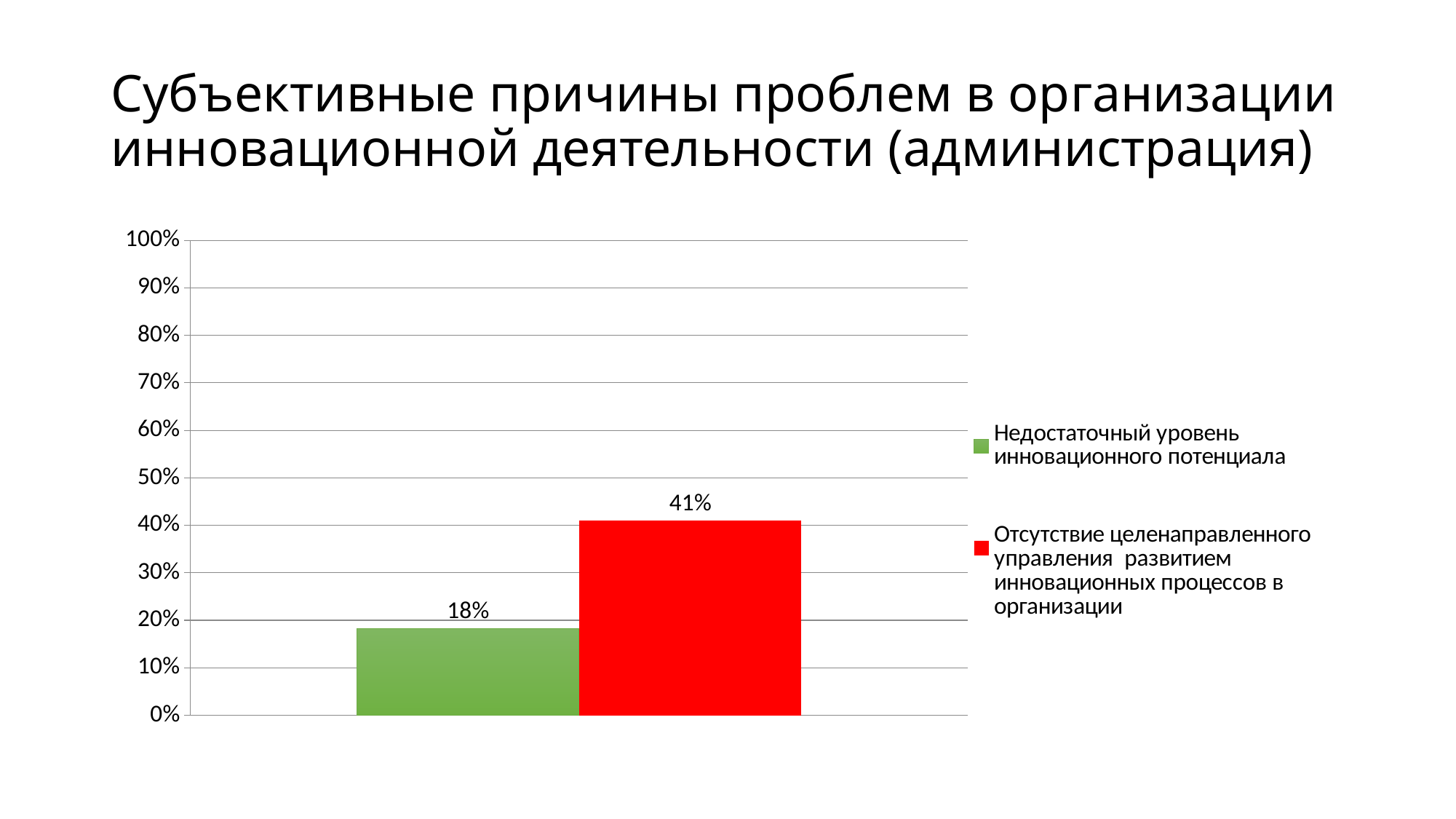
What kind of chart is shown on the slide? bar chart Is the value for 'Отсутствие целенаправленного управления развитием инновационных процессов в организации' greater or less than 50%? less Which series has the highest value? Отсутствие целенаправленного управления развитием инновационных процессов в организации Is the value for 'Недостаточный уровень инновационного потенциала' greater or less than 10%? greater What is the value for 'Недостаточный уровень инновационного потенциала'? 18% Which is larger: the value for 'Недостаточный уровень инновационного потенциала' or the value for 'Отсутствие целенаправленного управления развитием инновационных процессов в организации'? Отсутствие целенаправленного управления развитием инновационных процессов в организации What is the value for 'Отсутствие целенаправленного управления развитием инновационных процессов в организации'? 41% What is the difference between the values for 'Отсутствие целенаправленного управления развитием инновационных процессов в организации' and 'Недостаточный уровень инновационного потенциала'? 23% Which series has the lowest value? Недостаточный уровень инновационного потенциала How many series does the legend list? 2 How many bars are plotted on the chart? 2 What colour is the bar for 'Отсутствие целенаправленного управления развитием инновационных процессов в организации'? red